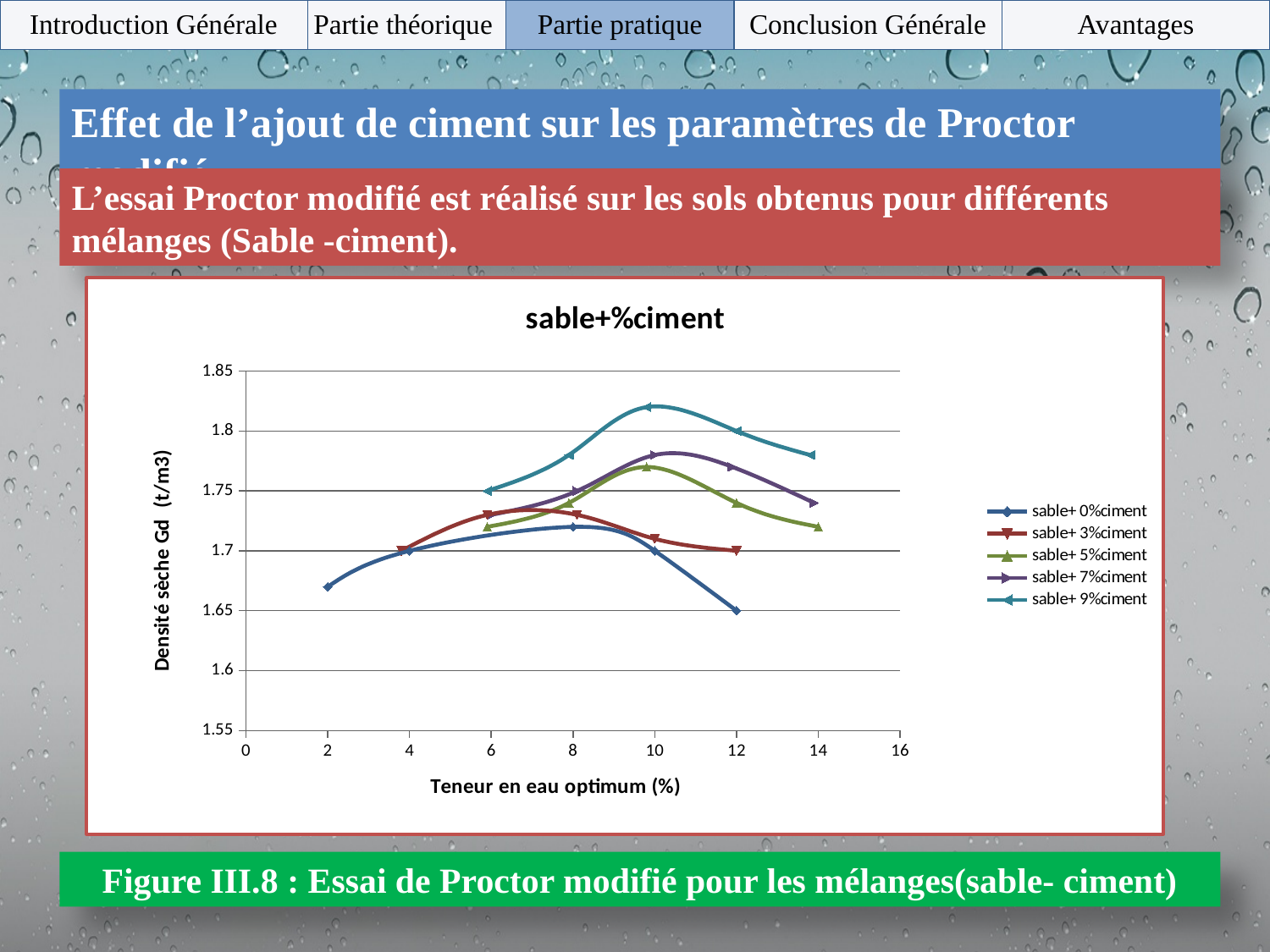
Does the sable+ 0%ciment series rise or fall between water contents of 8% and 12%? fall Is the value for sable+ 9%ciment at a water content of 10% greater or less than 1.8? greater What is the title of the chart? sable+%ciment Which series reaches the highest dry density on the chart? sable+ 9%ciment Is the value for sable+ 5%ciment at a water content of 14% greater or less than 1.75? less At a water content of 10%, which is larger: sable+ 9%ciment or sable+ 0%ciment? sable+ 9%ciment Which series has the lowest point on the chart? sable+ 0%ciment How many series does the chart legend list? 5 What is the value of sable+ 0%ciment at a water content of 12%? 1.65 What is the value of sable+ 9%ciment at a water content of 12%? 1.8 What is the label of the y axis? Densité sèche Gd (t/m3) What type of chart is shown on the slide? line chart